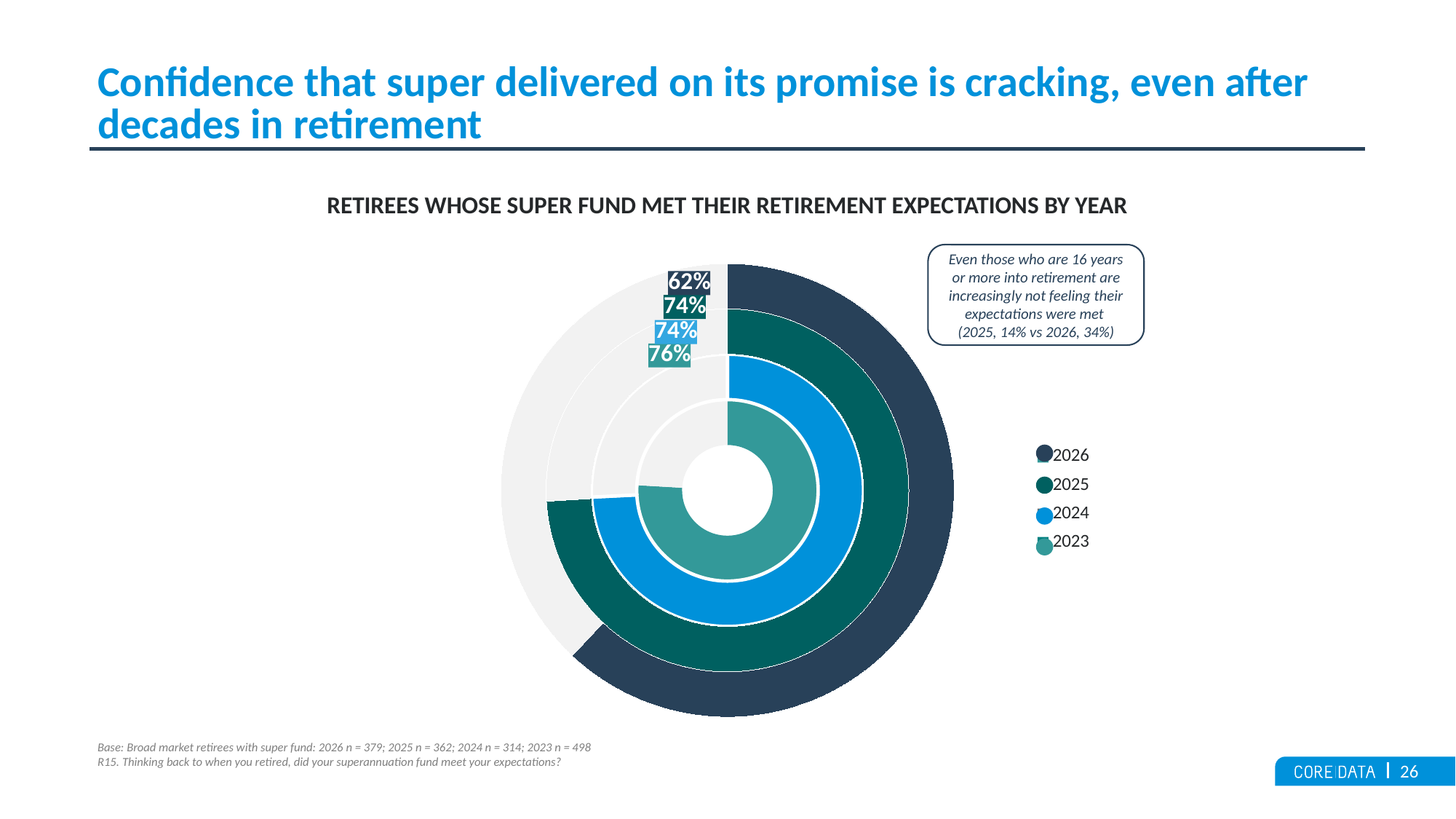
Which year has the lowest share of retirees whose super fund met their expectations? 2026 What percentage of retirees said their super fund met their retirement expectations in 2023? 76% How many entries does the legend list? 4 What type of chart is used on this slide? Doughnut chart Which year has the highest share of retirees whose super fund met their expectations? 2023 What percentage of retirees said their super fund met their retirement expectations in 2026? 62% What percentage of retirees said their super fund met their retirement expectations in 2025? 74% What is the difference in percentage points between the 2023 and 2026 values? 14 percentage points What is the title of the chart? Retirees whose super fund met their retirement expectations by year How many years are shown in the chart? 4 What percentage of retirees said their super fund met their retirement expectations in 2024? 74% Which is larger, the value for 2025 or the value for 2026? 2025